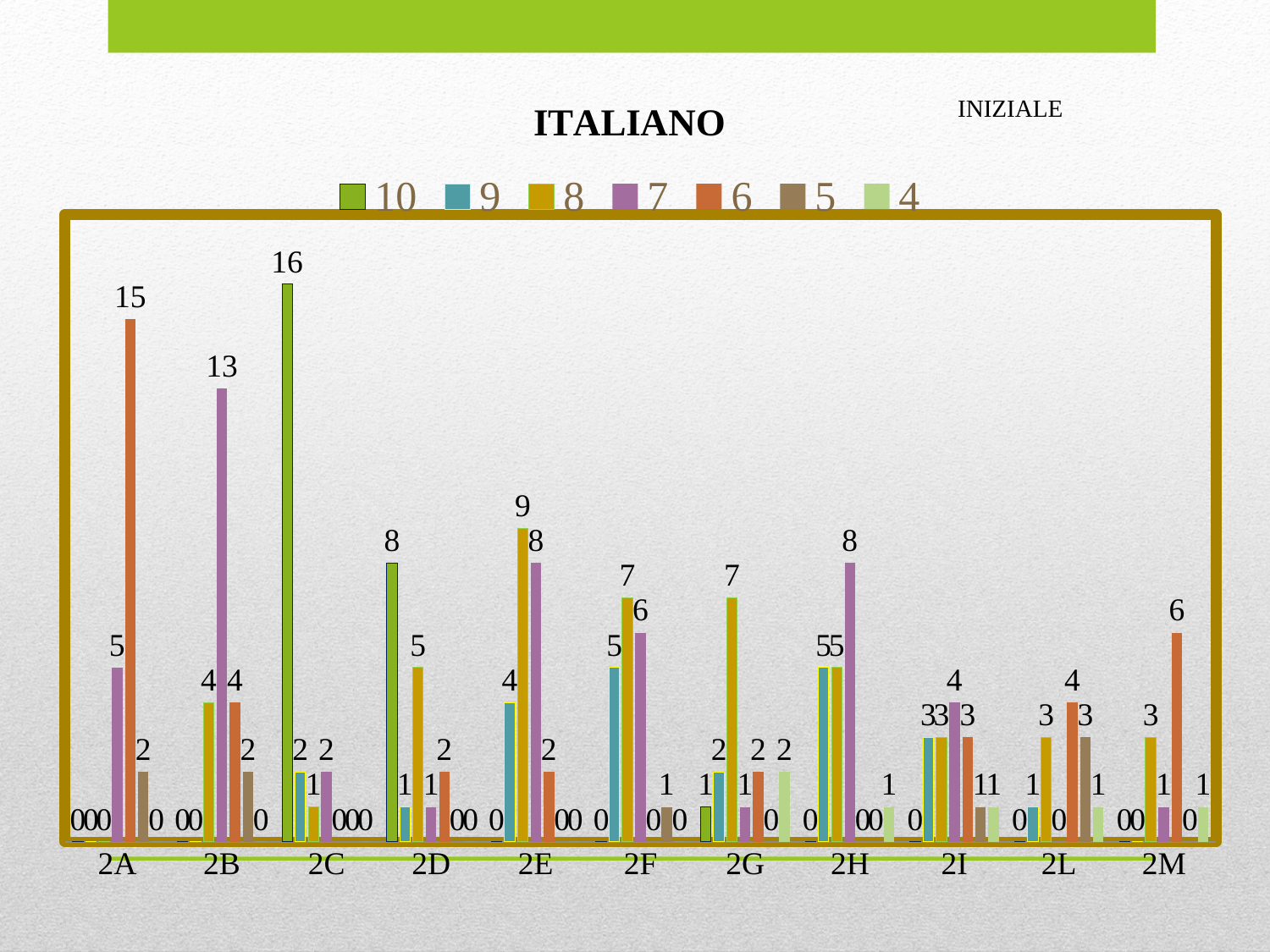
How many categories are shown on the x axis? 11 What is the value for series 8 in category 2E? 9 In category 2E, which is larger: the value for series 8 or the value for series 7? series 8 How many series does the legend list? 7 What kind of chart is shown on the slide? bar chart What is the difference between the values for series 6 and series 7 in category 2A? 10 What is the title of the chart? ITALIANO What is the value for series 10 in category 2C? 16 Which category has the highest value for series 10? 2C What is the value for series 7 in category 2B? 13 Which category has the highest value for series 6? 2A What is the value for series 6 in category 2A? 15